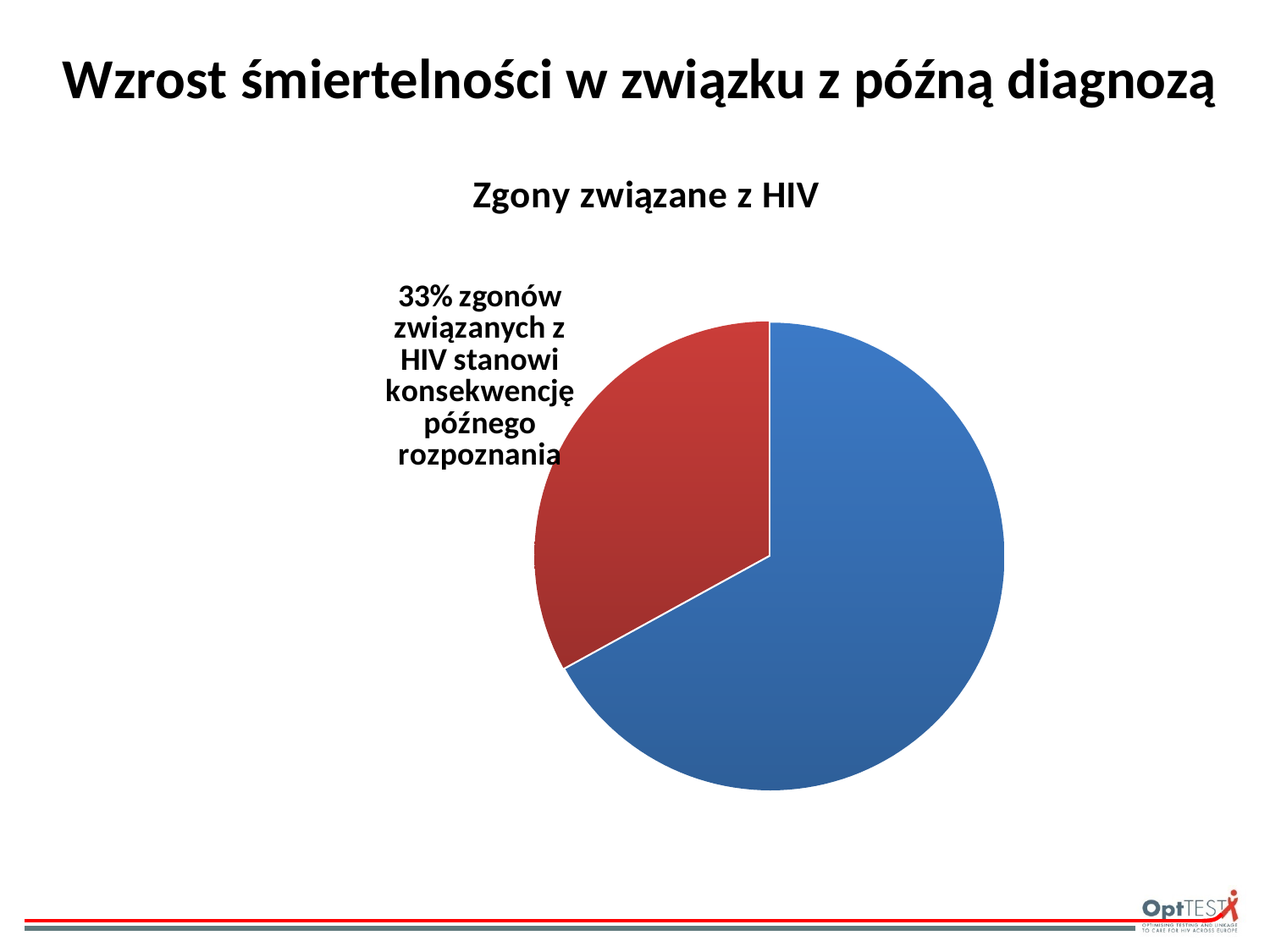
How many slices does the pie chart have? 2 What share of HIV-related deaths is attributed to late diagnosis (późne rozpoznanie) according to the chart label? 33% What colour is the slice labelled with the 33% late-diagnosis text? red Which slice of the pie is larger, the red one or the blue one? the blue one Which slice of the pie chart is the smallest? the red slice (33% zgonów związanych z HIV stanowi konsekwencję późnego rozpoznania) What kind of chart is shown on the slide? pie chart What is the title of the chart? Zgony związane z HIV Is the share of the red slice greater or less than 50%? less